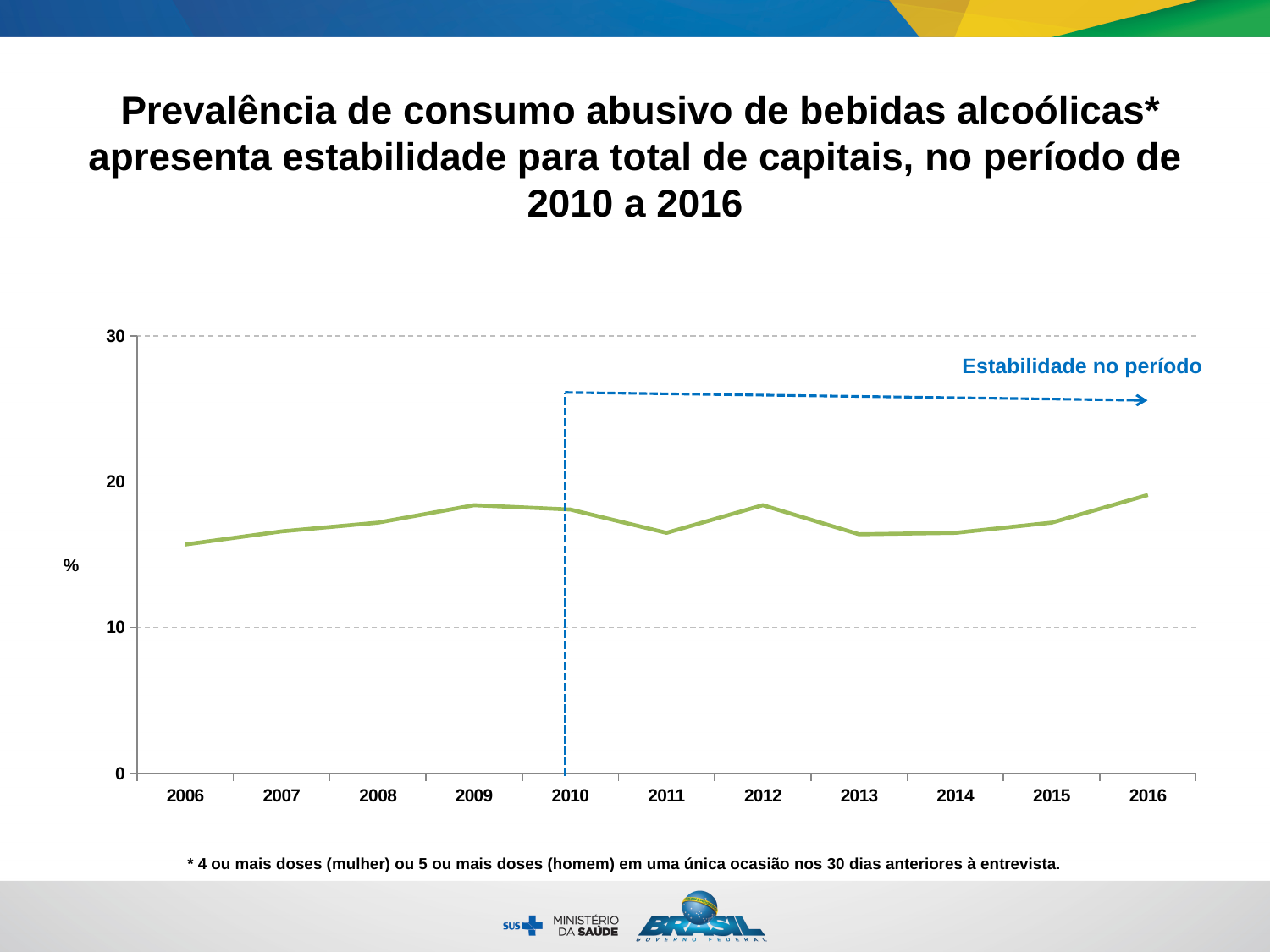
Which year has the lowest value on the chart? 2006 Is the value for 2006 greater or less than 10? greater How many years are shown on the x axis of the chart? 11 What kind of chart is shown on the slide? line chart Is the value for 2016 greater or less than 20? less What text is written next to the dashed blue arrow on the chart? Estabilidade no período Which year has the highest value on the chart? 2016 Which year has the larger value, 2009 or 2011? 2009 Which year has the larger value, 2012 or 2013? 2012 Do the values rise or fall from 2006 to 2009? rise What label is shown on the y axis of the chart? % Is the value for 2009 greater or less than 20? less